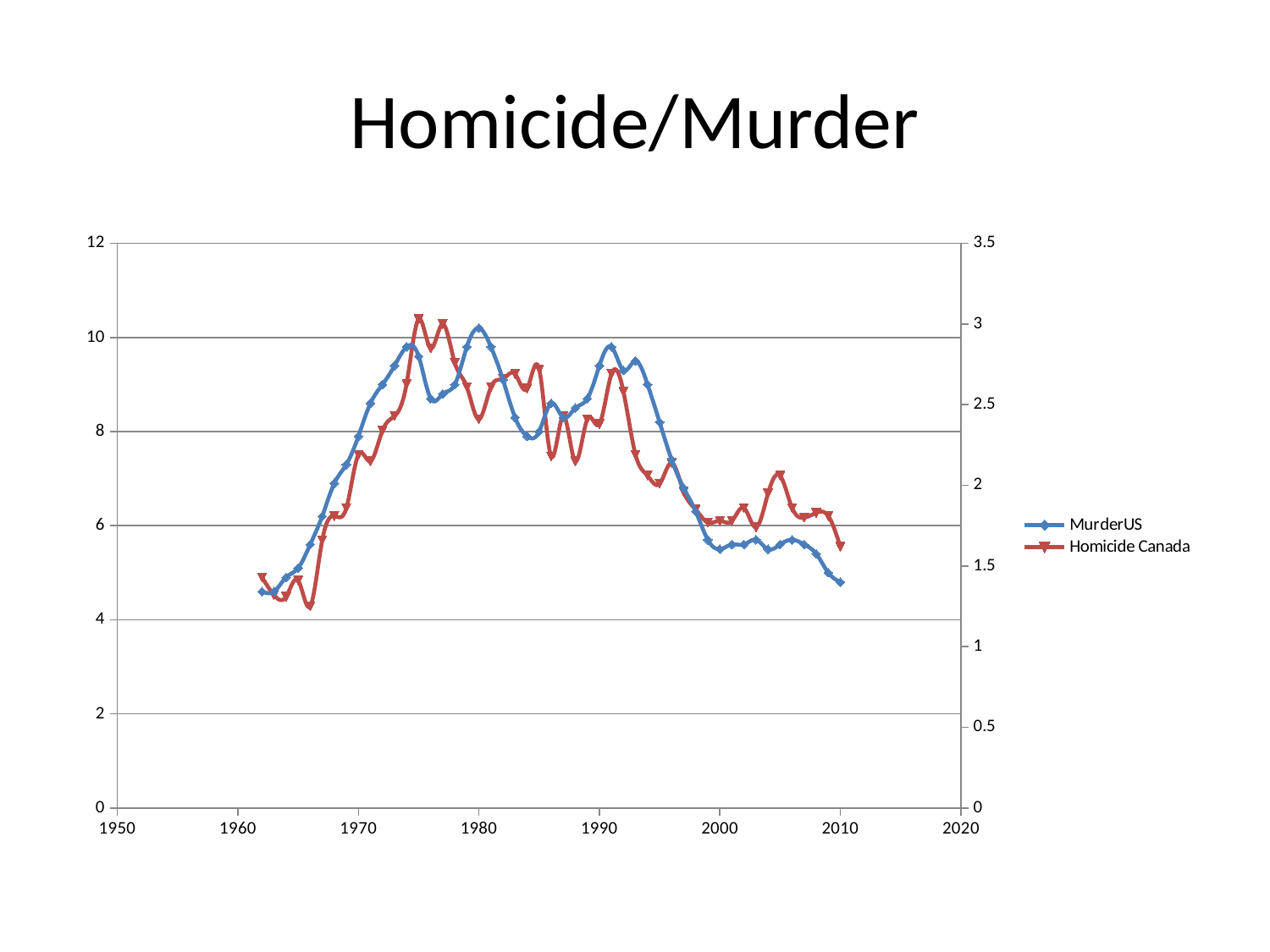
Is the MurderUS value for 2010 greater or less than 6? less What is the title of the chart? Homicide/Murder How many series does the legend list? 2 Is the Homicide Canada value for 1975 greater or less than 2.5? greater Is the Homicide Canada value for 2010 greater or less than 2? less What kind of chart is shown on the slide? line chart Does the MurderUS series rise or fall between 1962 and 1974? rise Does the MurderUS series rise or fall between 1993 and 2000? fall Which series is drawn in red? Homicide Canada